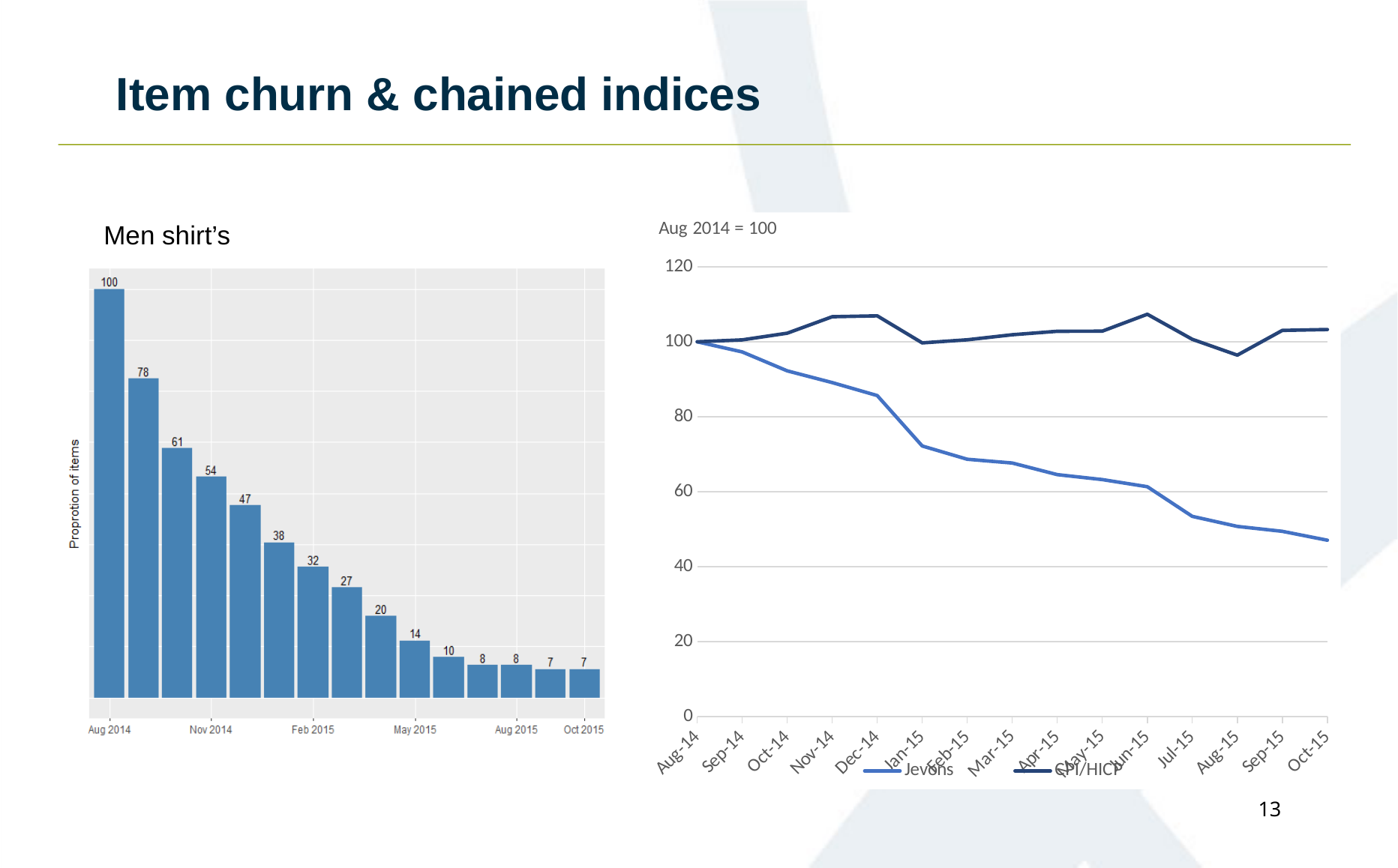
On the left bar chart (Men shirt's), how many bars are plotted? 15 On the right line chart (Aug 2014 = 100), is the Jevons value for Oct-15 greater or less than 60? less On the left bar chart (Men shirt's), what is the value for Feb 2015? 32 On the left bar chart (Men shirt's), do the values rise or fall from Aug 2014 to Oct 2015? fall On the left bar chart (Men shirt's), what is the value for Oct 2015? 7 On the right line chart (Aug 2014 = 100), how many series does the legend list? 2 On the left bar chart (Men shirt's), what is the value for Aug 2014? 100 On the left bar chart (Men shirt's), what is the value for Nov 2014? 54 What kind of chart is the left chart (Men shirt's)? bar chart On the right line chart (Aug 2014 = 100), which series is higher at Oct-15, Jevons or CPI/HICP? CPI/HICP On the left bar chart (Men shirt's), what is the difference between the Aug 2014 value and the Nov 2014 value? 46 On the left bar chart (Men shirt's), what is the value for May 2015? 14